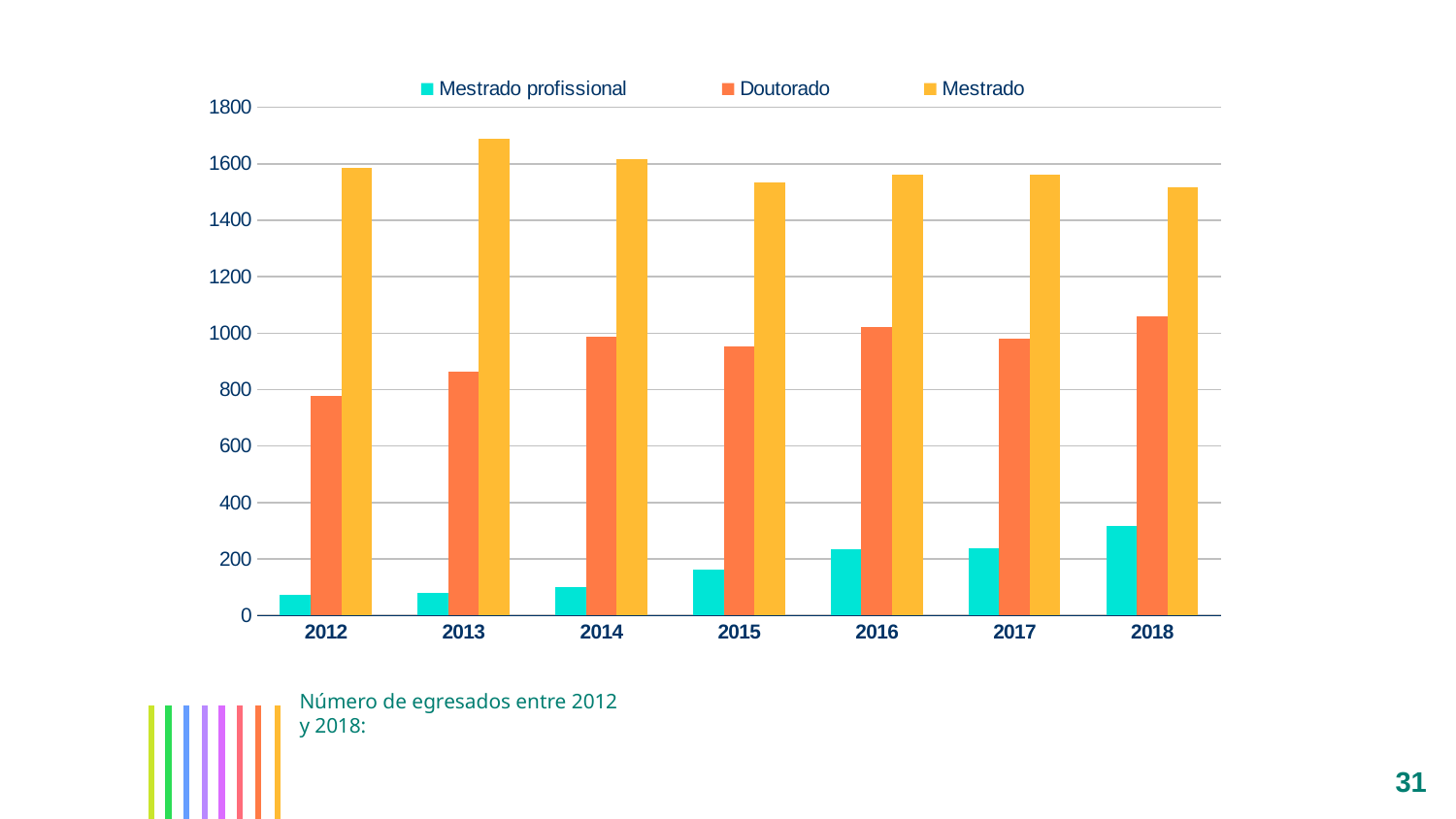
Is the Doutorado value for 2012 greater or less than 800? less In which year is the Doutorado value lowest? 2012 Which is larger, the Doutorado value for 2014 or for 2012? 2014 Is the Mestrado profissional value for 2018 greater or less than 200? greater In which year is the Mestrado profissional value highest? 2018 Do the Mestrado profissional values generally rise or fall from 2012 to 2018? rise How many series does the legend list? 3 Is the Mestrado value for 2013 greater or less than 1600? greater How many years are shown on the x axis? 7 Which series is shown in yellow in the legend? Mestrado What kind of chart is shown on the slide? bar chart In which year is the Mestrado value highest? 2013